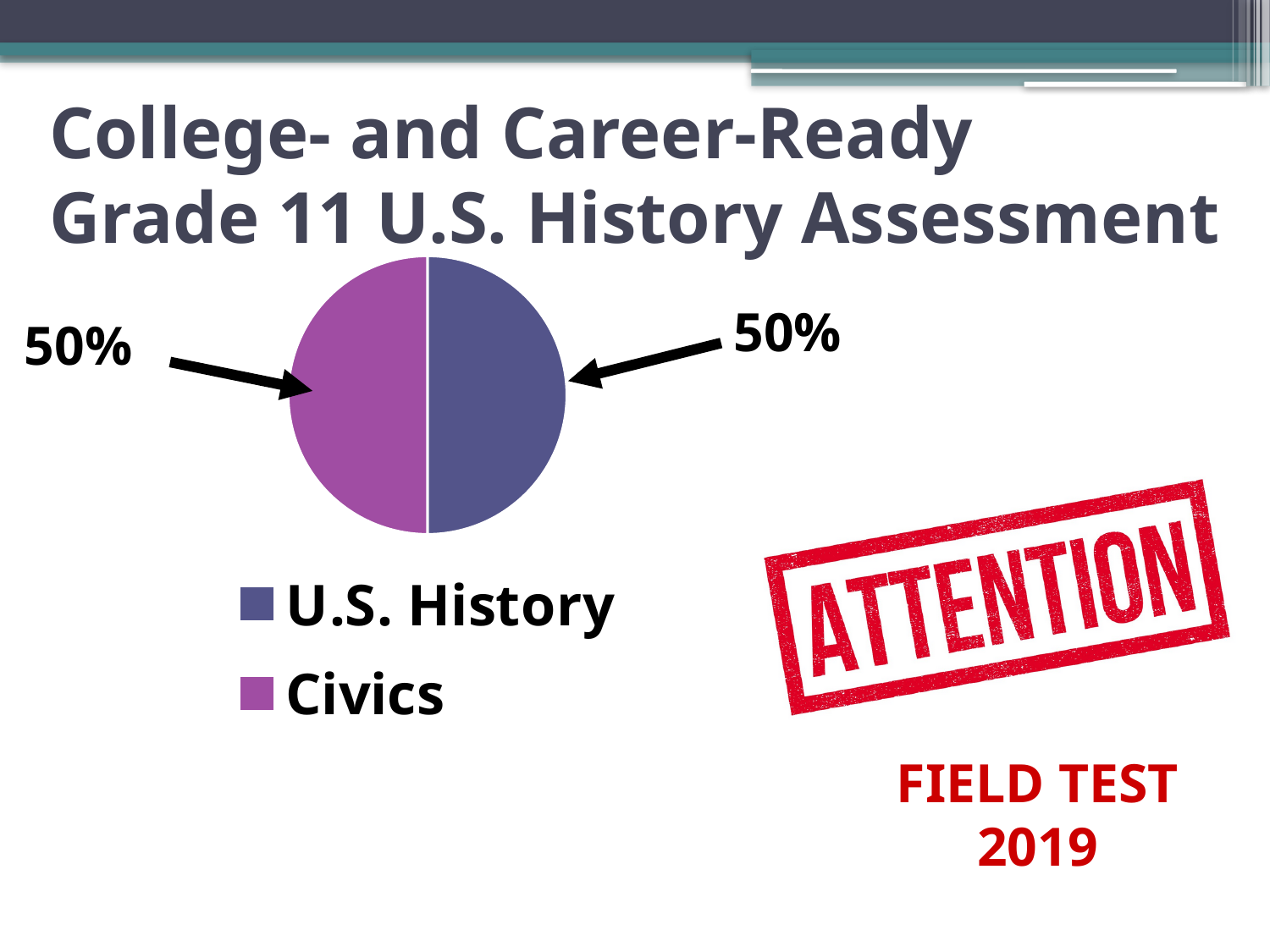
Is the share for Civics greater or less than 25%? greater What is the total of the two slices shown in the pie chart? 100% What kind of chart is shown on the slide? pie chart How many entries does the legend list? 2 How many slices does the pie chart have? 2 What share of the pie does U.S. History represent? 50% Which legend entry is shown in the darker blue-violet colour? U.S. History What is the difference between the U.S. History share and the Civics share? 0% What share of the pie does Civics represent? 50% Which legend entry is shown in purple (the lighter, magenta-toned colour)? Civics